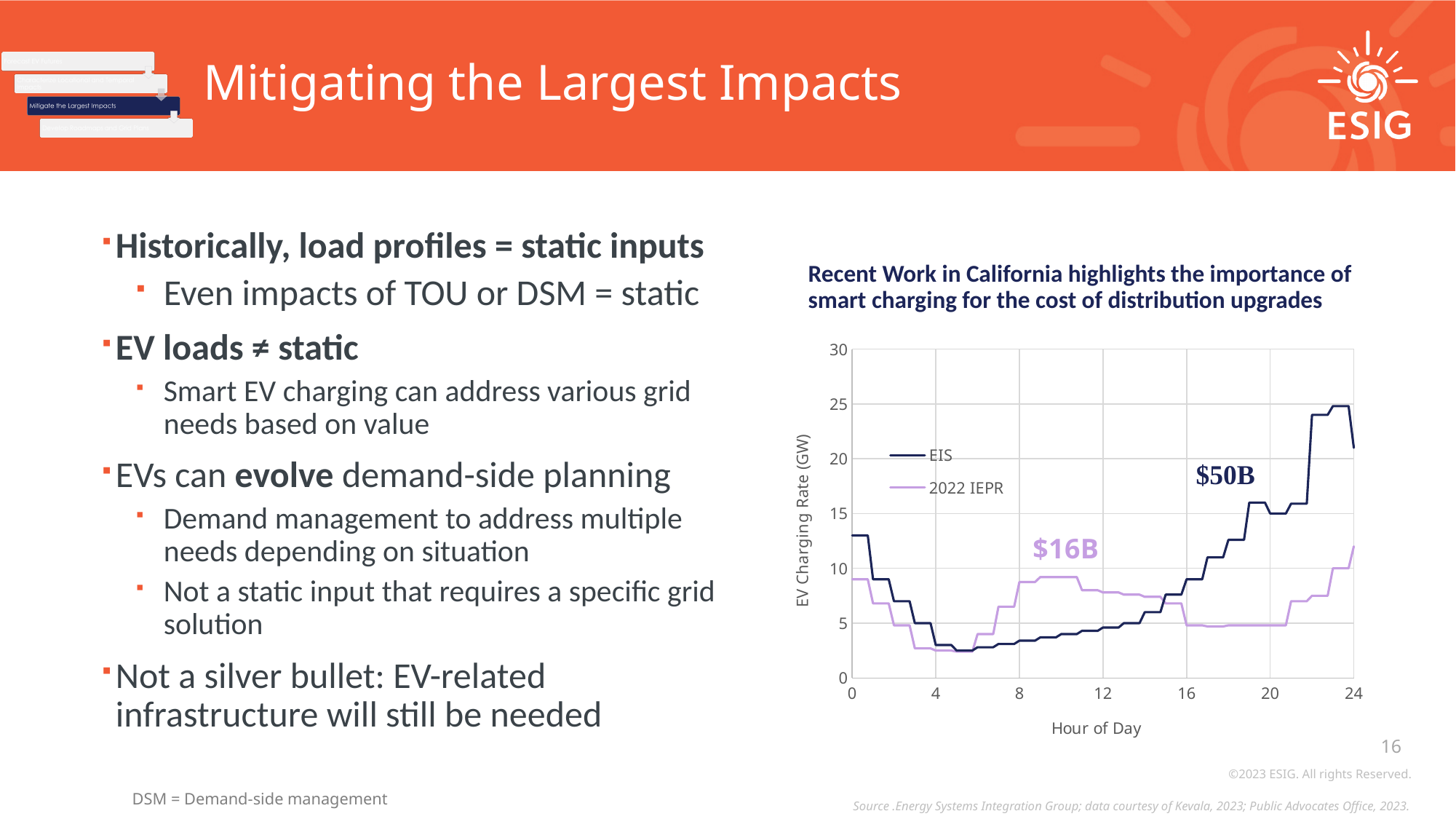
How many series does the chart legend list? 2 What are the two series named in the chart legend? EIS and 2022 IEPR At hour 22, which series has the higher EV charging rate, EIS or 2022 IEPR? EIS Is the EIS value at hour 0 greater or less than 10 GW? greater Which series reaches the highest EV charging rate on the chart? EIS Is the EIS value at hour 5 greater or less than 5 GW? less Does the EIS series rise or fall between hour 16 and hour 23? rise What kind of chart is shown on the slide? line chart Is the 2022 IEPR value at hour 24 greater or less than 10 GW? greater At hour 9, which series has the higher EV charging rate, EIS or 2022 IEPR? 2022 IEPR What is the title of the chart's x axis? Hour of Day